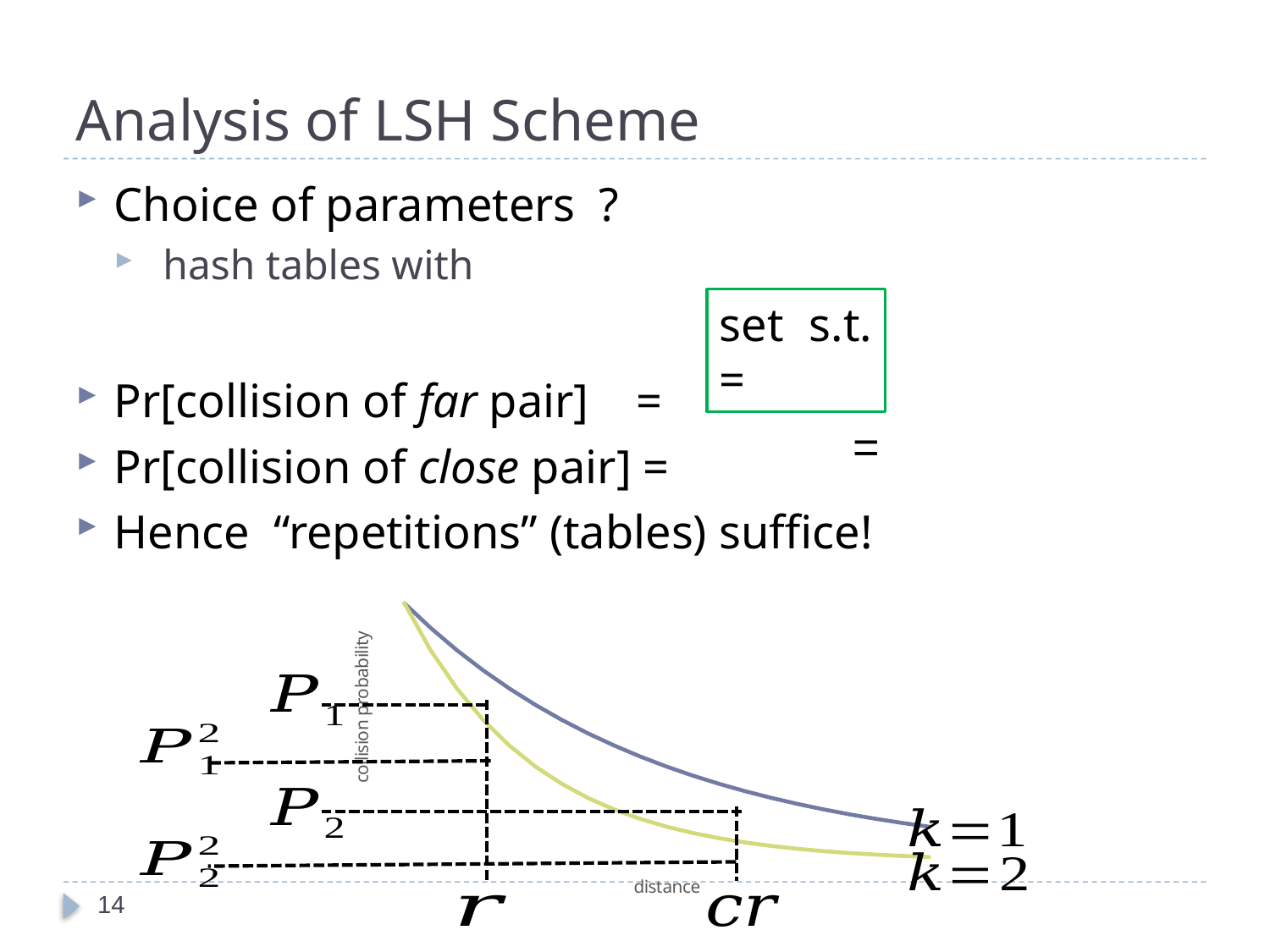
How many curves are plotted in the chart? 2 Which curve lies higher at distance cr, k=1 or k=2? k=1 Which of the two marked distances, r or cr, has the higher collision probability on the k=1 curve? r What is the label of the y axis of the chart? collision probability Which curve lies lower at distance r, k=1 or k=2? k=2 Which curve decreases faster with distance, k=1 or k=2? k=2 Do the curves in the chart rise or fall as distance increases? fall What are the two distance values marked on the x axis of the chart? r and cr What is the label of the x axis of the chart? distance What kind of chart is shown at the bottom of the slide? line chart